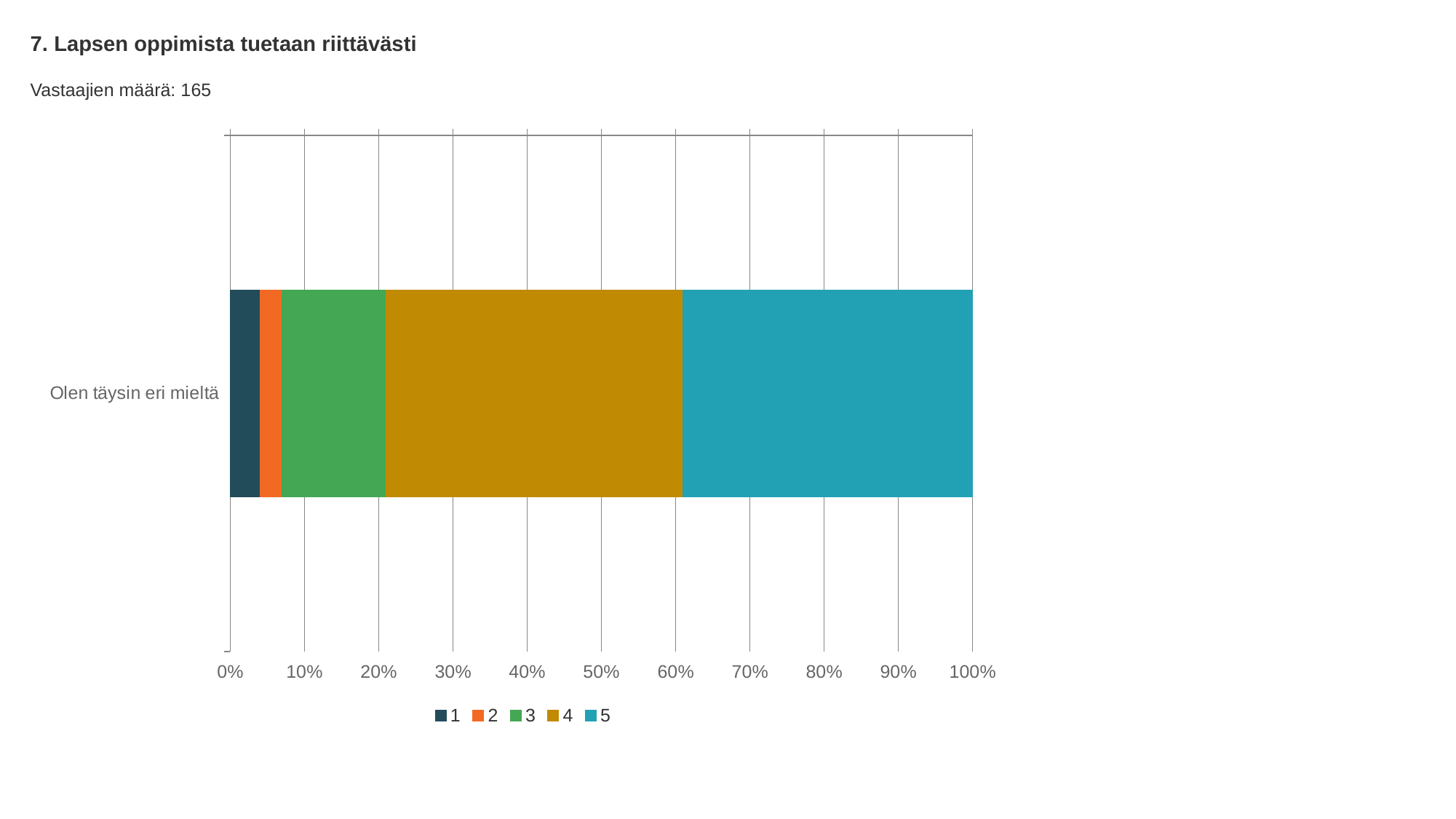
What is the title of the chart? 7. Lapsen oppimista tuetaan riittävästi What is the total of the stacked bar, as read from the x axis where it ends? 100% How many series does the legend list? 5 Is the share for series 3 greater or less than 20%? less Is the share for series 4 greater or less than 30%? greater What kind of chart is shown on the slide? Stacked bar chart Which is larger in the stacked bar: the segment for series 4 or the segment for series 3? 4 Is the share for series 1 greater or less than 10%? less How many categories (bars) are plotted in the chart? 1 Which is larger in the stacked bar: the segment for series 3 or the segment for series 1? 3 What is the number of respondents (Vastaajien määrä) shown on the slide? 165